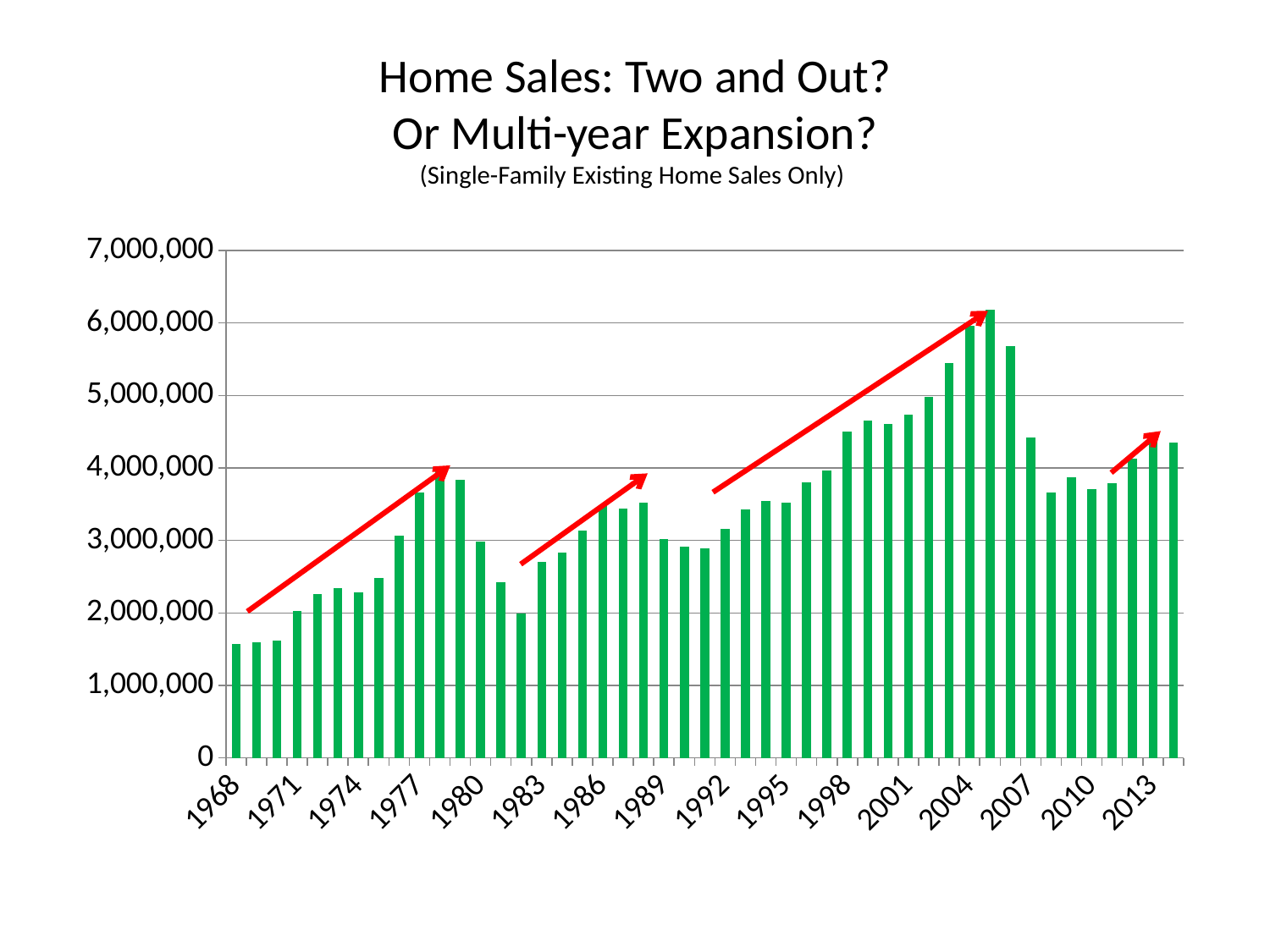
Is the value for 2006 greater or less than 5,000,000? greater Which year has the larger value, 2006 or 2007? 2006 Which year has the highest value in the chart? 2005 Is the value for 2005 greater or less than 6,000,000? greater Is the value for 1981 greater or less than 3,000,000? less What colour are the bars in the chart? Green Which year has the larger value, 1979 or 1980? 1979 Do the values rise or fall from 2005 to 2008? Fall What is the title of the chart on the slide? Home Sales: Two and Out? Or Multi-year Expansion? What kind of chart is shown on the slide? Bar chart